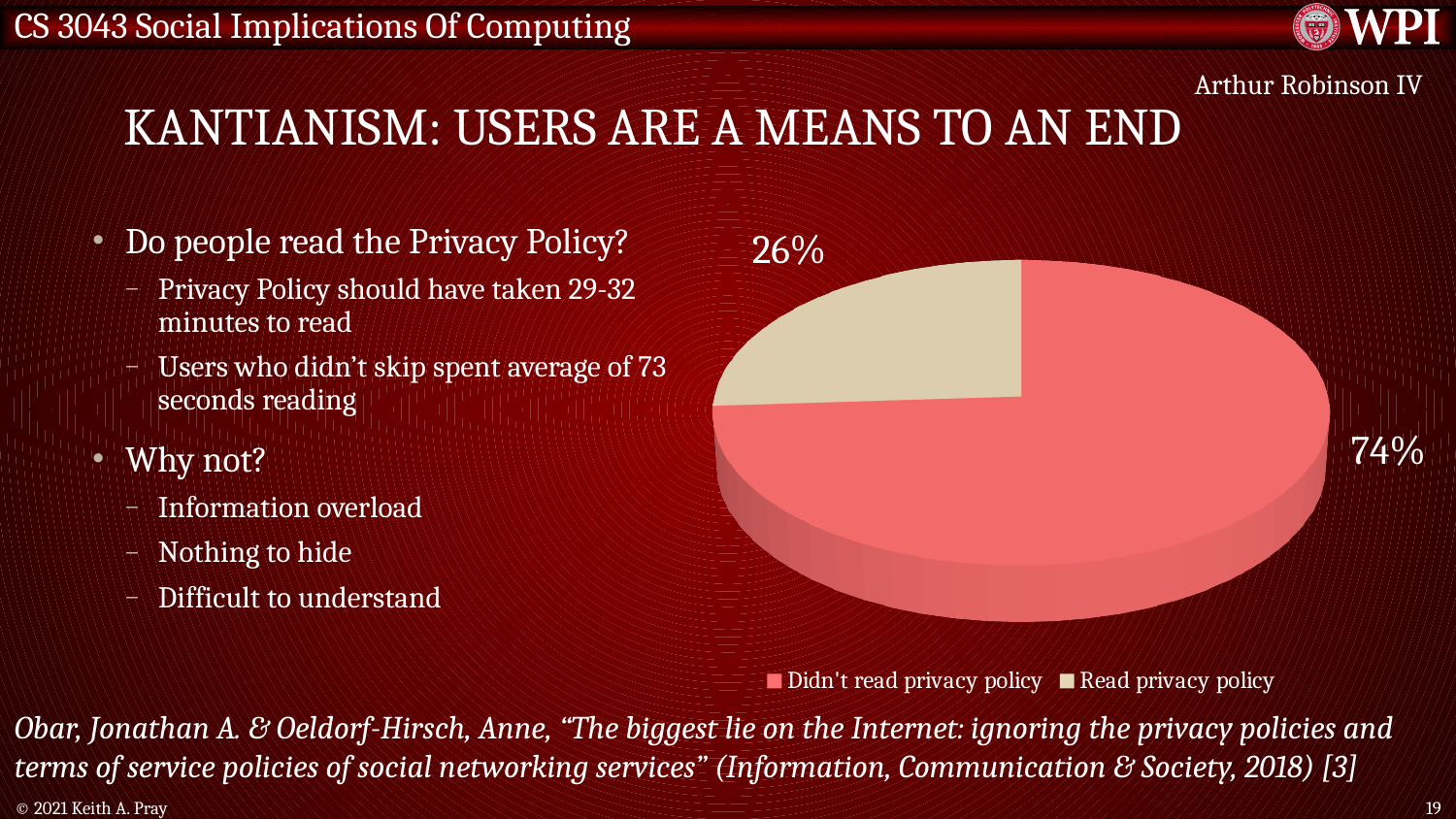
What share of the pie does the "Read privacy policy" slice represent? 26% How many entries does the chart legend list? 2 What percentage of the pie is labelled for "Read privacy policy"? 26% What is the difference in percentage points between the "Didn't read privacy policy" slice and the "Read privacy policy" slice? 48 Which slice of the pie is the smallest? Read privacy policy What kind of chart is shown on the slide? Pie chart What colour is the "Read privacy policy" slice in the pie chart? Beige What colour is the "Didn't read privacy policy" slice in the pie chart? Red Which is larger: the share of users who read the privacy policy or the share who didn't? Didn't read privacy policy How many slices does the pie chart have? 2 Which slice of the pie is the largest? Didn't read privacy policy What percentage of the pie is labelled for "Didn't read privacy policy"? 74%